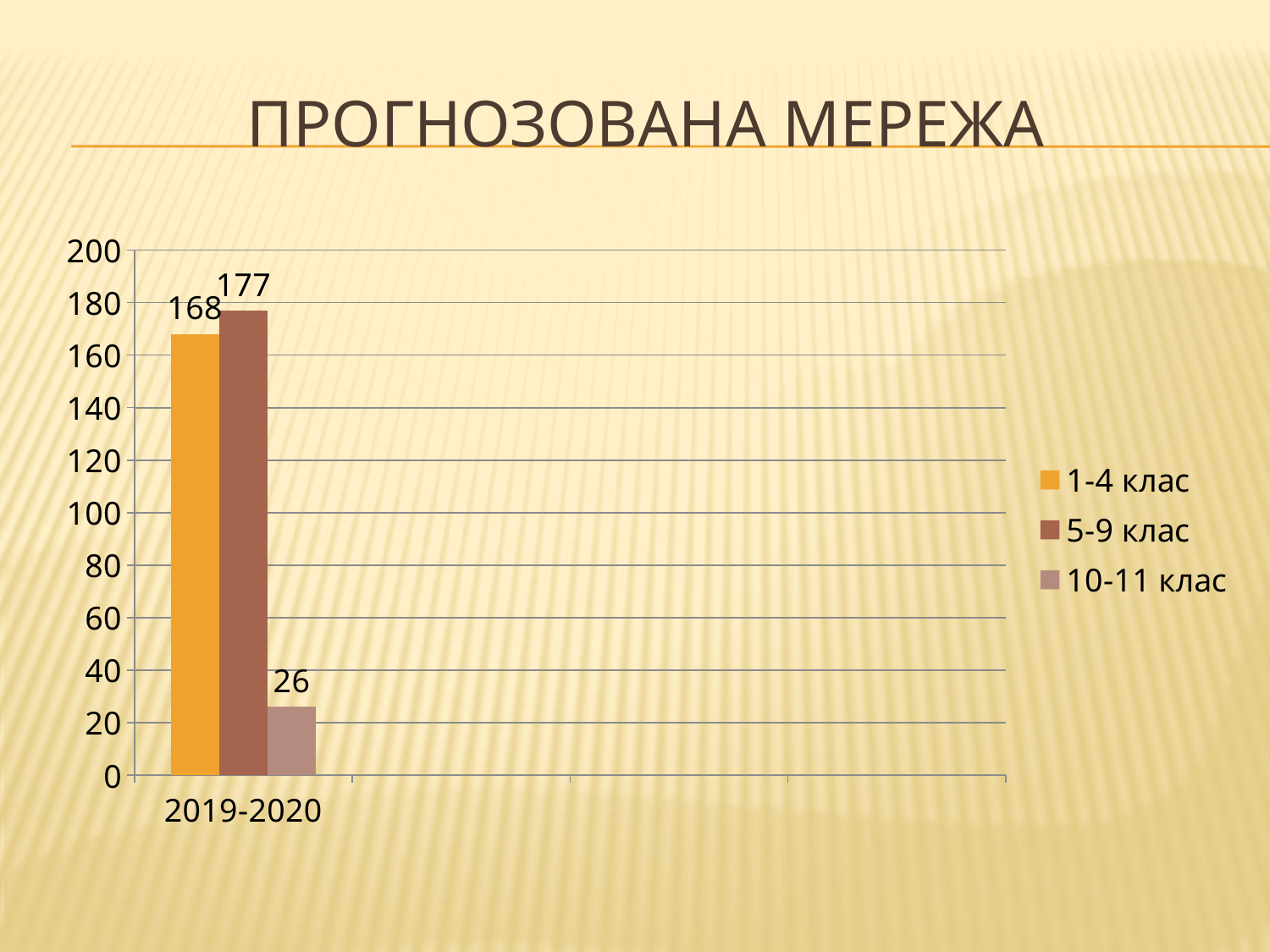
What is the title of the slide? ПРОГНОЗОВАНА МЕРЕЖА What is the value for 5-9 клас in 2019-2020? 177 What is the difference between the values for 1-4 клас and 10-11 клас? 142 What is the value for 1-4 клас in 2019-2020? 168 Which series has the highest value in 2019-2020? 5-9 клас Which is larger, the value for 1-4 клас or the value for 10-11 клас? 1-4 клас What is the value for 10-11 клас in 2019-2020? 26 What is the difference between the values for 5-9 клас and 1-4 клас? 9 Is the value for 5-9 клас greater or less than 160? greater How many series does the legend list? 3 Which series has the lowest value in 2019-2020? 10-11 клас What kind of chart is shown on the slide? bar chart